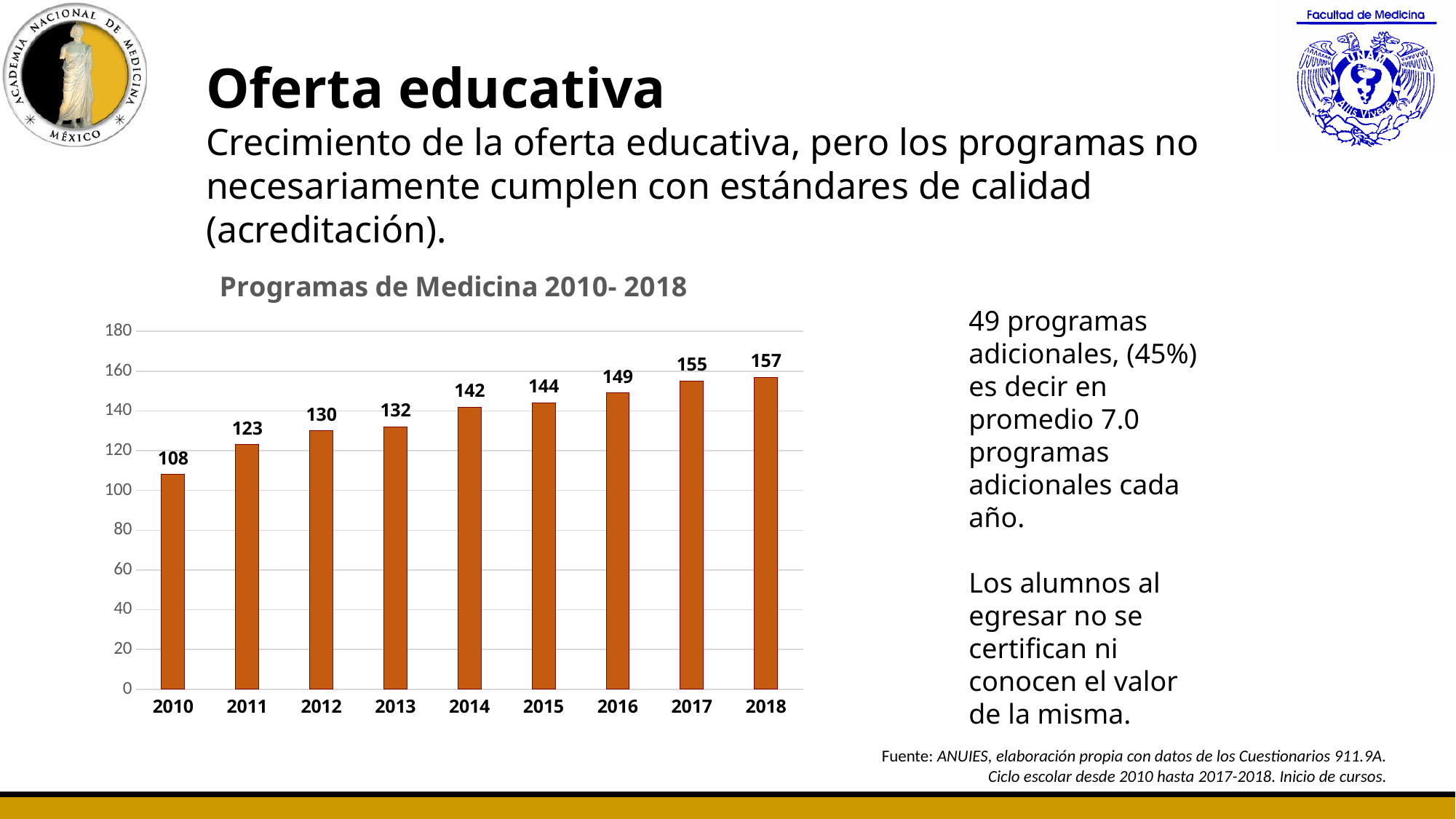
Is the value for 2011 greater or less than 120? greater What is the value for 2018? 157 Which year has the lowest value? 2010 What is the difference between the values for 2018 and 2010? 49 Do the values rise or fall from 2010 to 2018? rise Which year has the highest value? 2018 How many years are shown on the x axis? 9 What is the value for 2014? 142 Which is larger, the value for 2012 or the value for 2013? 2013 What kind of chart is shown? bar chart What is the value for 2010? 108 What is the difference between the values for 2016 and 2015? 5